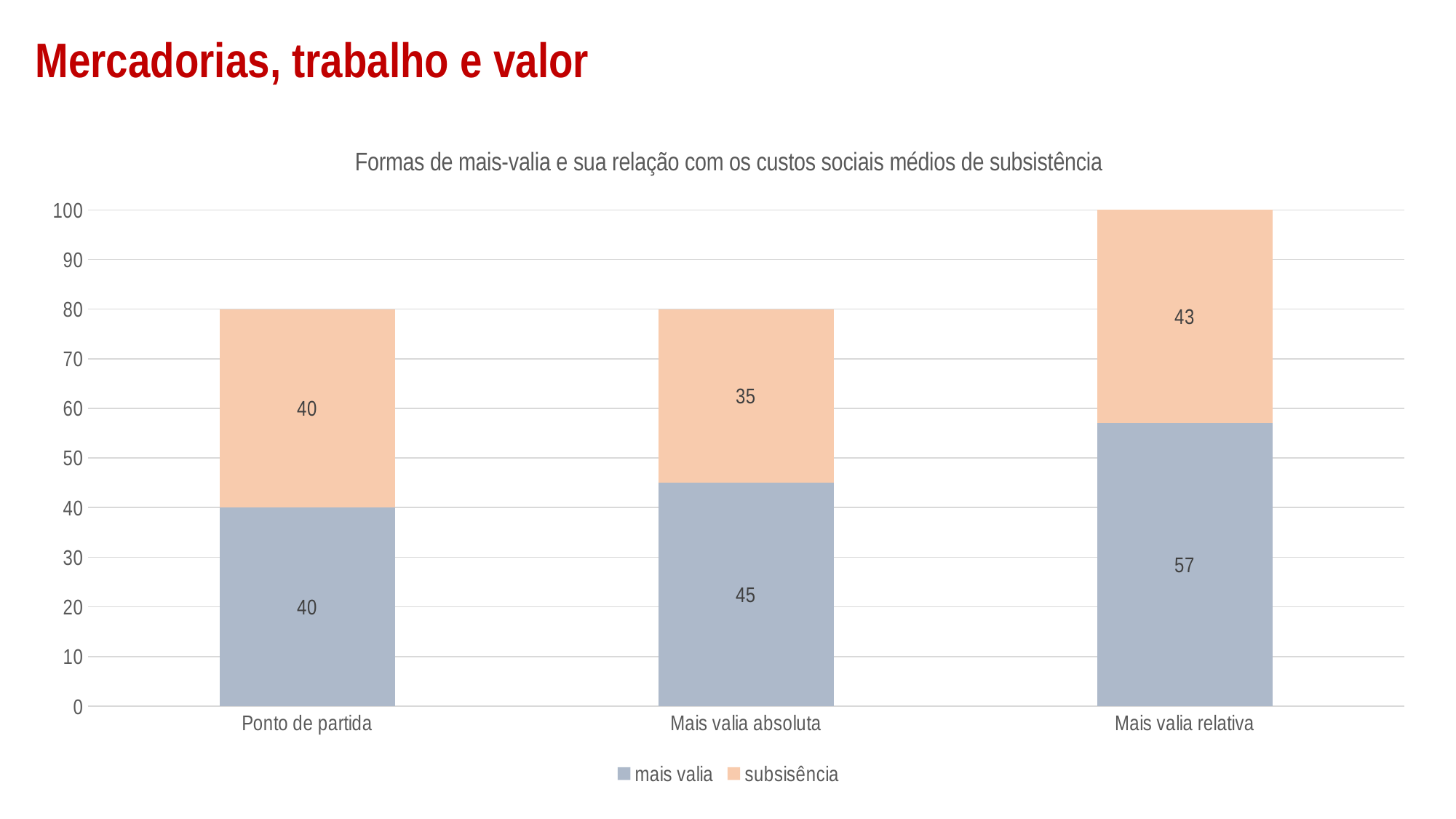
What is the total of the stacked bar for 'Mais valia absoluta'? 80 What is the value of 'mais valia' for 'Mais valia relativa'? 57 What is the difference between the 'mais valia' values for 'Mais valia relativa' and 'Ponto de partida'? 17 Which category has the lowest 'subsisência' value? Mais valia absoluta What type of chart is shown on the slide? Stacked bar chart How many series does the legend list? 2 What is the value of 'subsisência' for 'Mais valia absoluta'? 35 Which is larger: 'subsisência' for 'Mais valia relativa' or 'subsisência' for 'Ponto de partida'? Mais valia relativa Which category has the highest 'mais valia' value? Mais valia relativa What is the total of the stacked bar for 'Mais valia relativa'? 100 How many categories are shown on the x axis? 3 What is the value of 'mais valia' for 'Ponto de partida'? 40